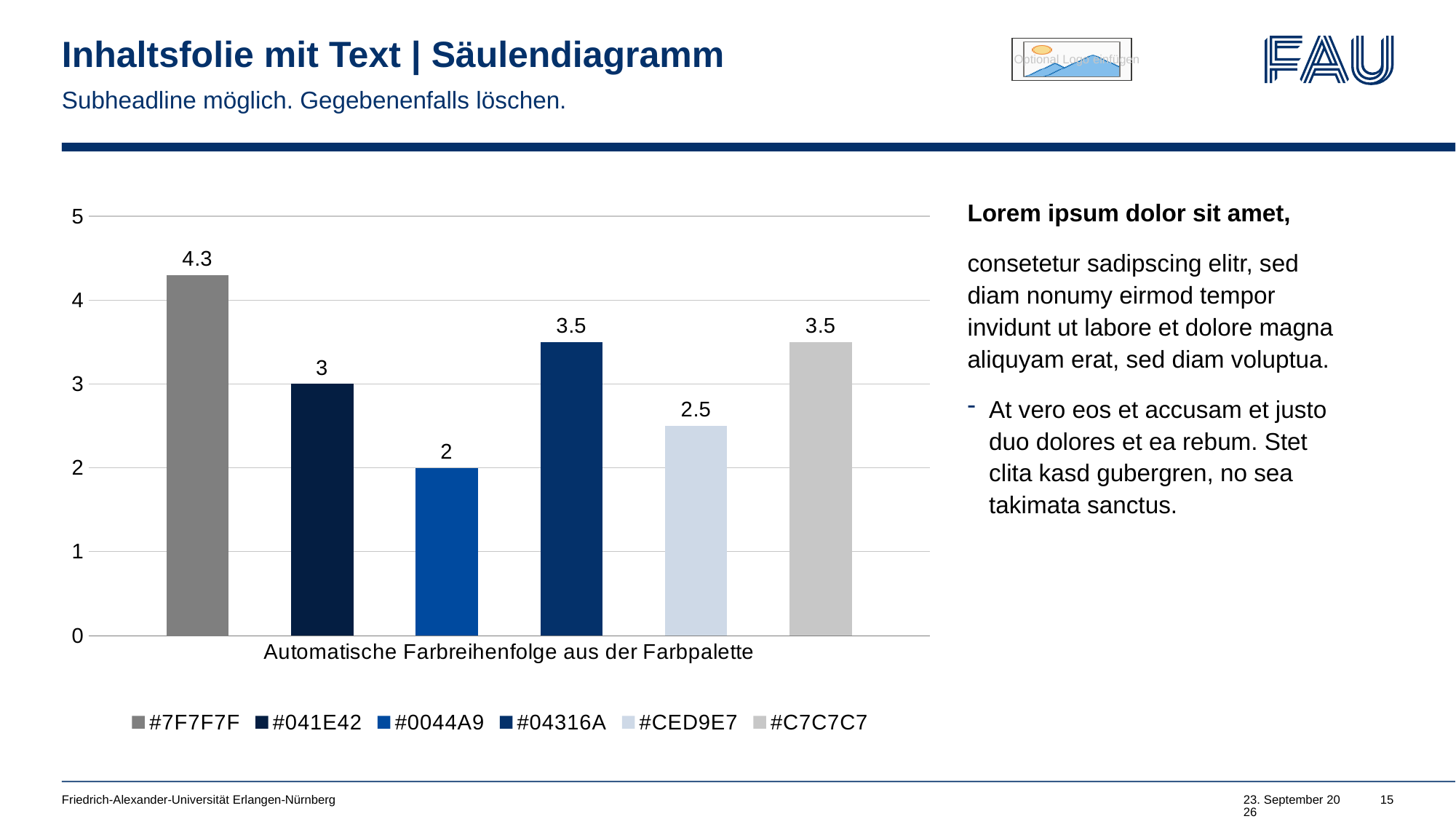
What is the value of the #CED9E7 series? 2.5 Which series has the lowest value? #0044A9 How many series does the legend list? 6 What is the category label shown on the x axis? Automatische Farbreihenfolge aus der Farbpalette Which series has the highest value? #7F7F7F What is the value of the #7F7F7F series? 4.3 Which is larger, the value for #041E42 or the value for #C7C7C7? #C7C7C7 What is the value of the #0044A9 series? 2 What is the value of the #041E42 series? 3 What is the difference between the #7F7F7F value and the #041E42 value? 1.3 What kind of chart is shown on the slide? Bar chart What is the difference between the #04316A value and the #CED9E7 value? 1